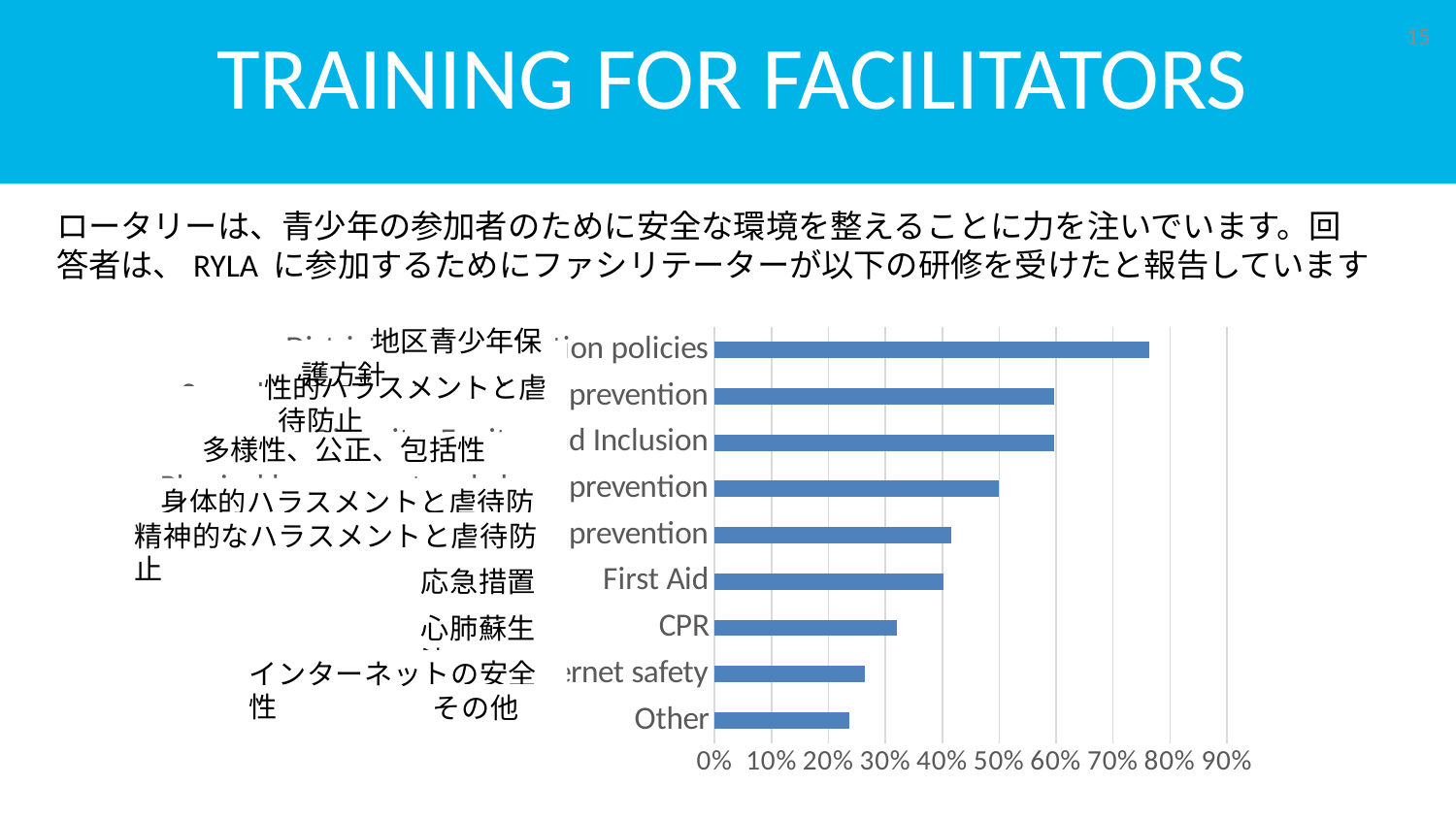
Is the value for CPR greater or less than 40%? less What is the highest tick label shown on the horizontal axis? 90% Which is larger, the value for First Aid or the value for CPR? First Aid Which bar is the longest in the chart? the top bar (…ion policies / 地区青少年保護方針) Is the value for Other greater or less than 30%? less Do the bar values increase or decrease going from the top category to the bottom category? decrease Is the value for First Aid greater or less than 30%? greater What kind of chart is shown on the slide? bar chart How many categories (bars) does the chart show? 9 Which category has the lowest value in the chart? Other